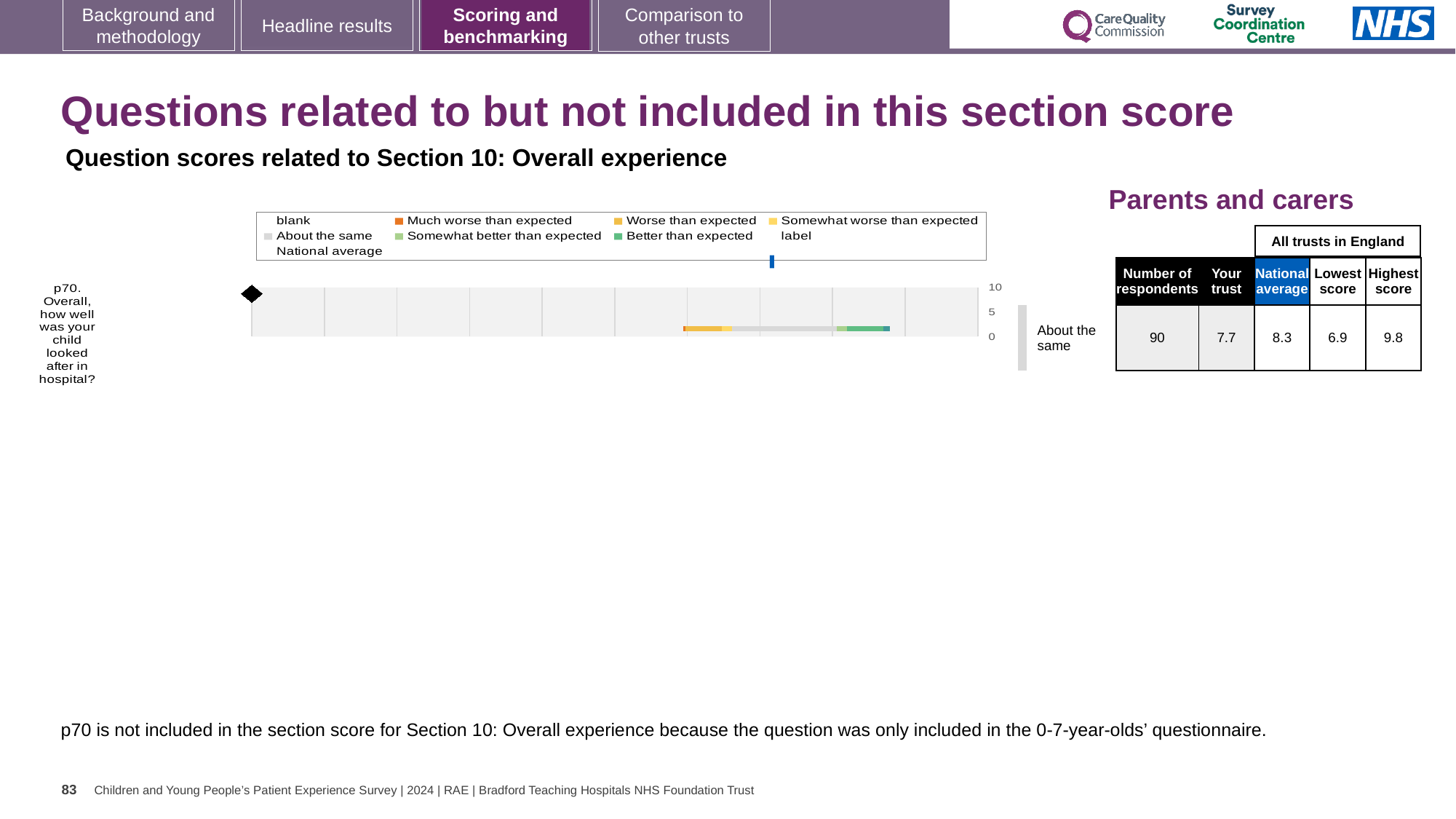
What is the highest score among all trusts in England for p70? 9.8 Which is higher for p70: the trust's score or the national average? National average How many respondents answered p70 for this trust? 90 How many questions are plotted in the chart? 1 What is the lowest score among all trusts in England for p70? 6.9 What is the maximum value shown on the chart's score axis? 10 What is the difference between the highest and lowest scores for p70 across all trusts in England? 2.9 What is the 'Your trust' score for p70 shown on the slide? 7.7 What benchmark category label is shown next to the chart for the trust's p70 result? About the same By how much does the national average exceed the trust's score for p70? 0.6 What kind of chart is used to show the p70 question score? bar chart What is the national average score for p70 shown on the slide? 8.3